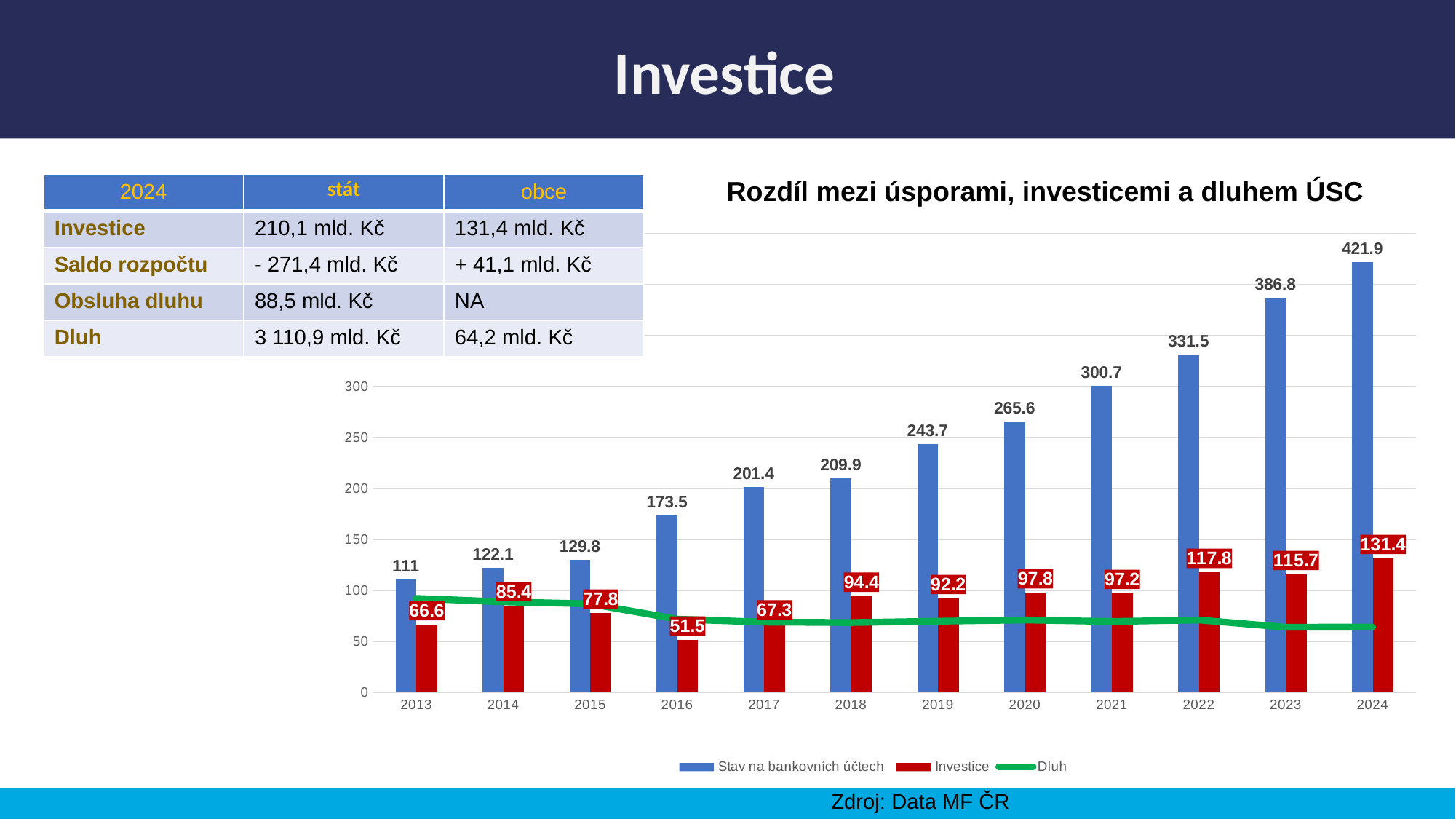
Is the value of Dluh for 2024 greater or less than 100? less In which year is Investice highest? 2024 How many series does the chart legend list? 3 In which year is Investice lowest? 2016 What is the difference between Stav na bankovních účtech in 2024 and in 2023? 35.1 What is the value of Investice for 2016? 51.5 Which year has the larger Investice value, 2014 or 2015? 2014 What kind of chart is shown on the slide? bar chart with a line Does Stav na bankovních účtech rise or fall from 2013 to 2024? rises How many years are shown on the x axis of the chart? 12 What is the value of Stav na bankovních účtech for 2019? 243.7 What is the title of the chart? Rozdíl mezi úsporami, investicemi a dluhem ÚSC